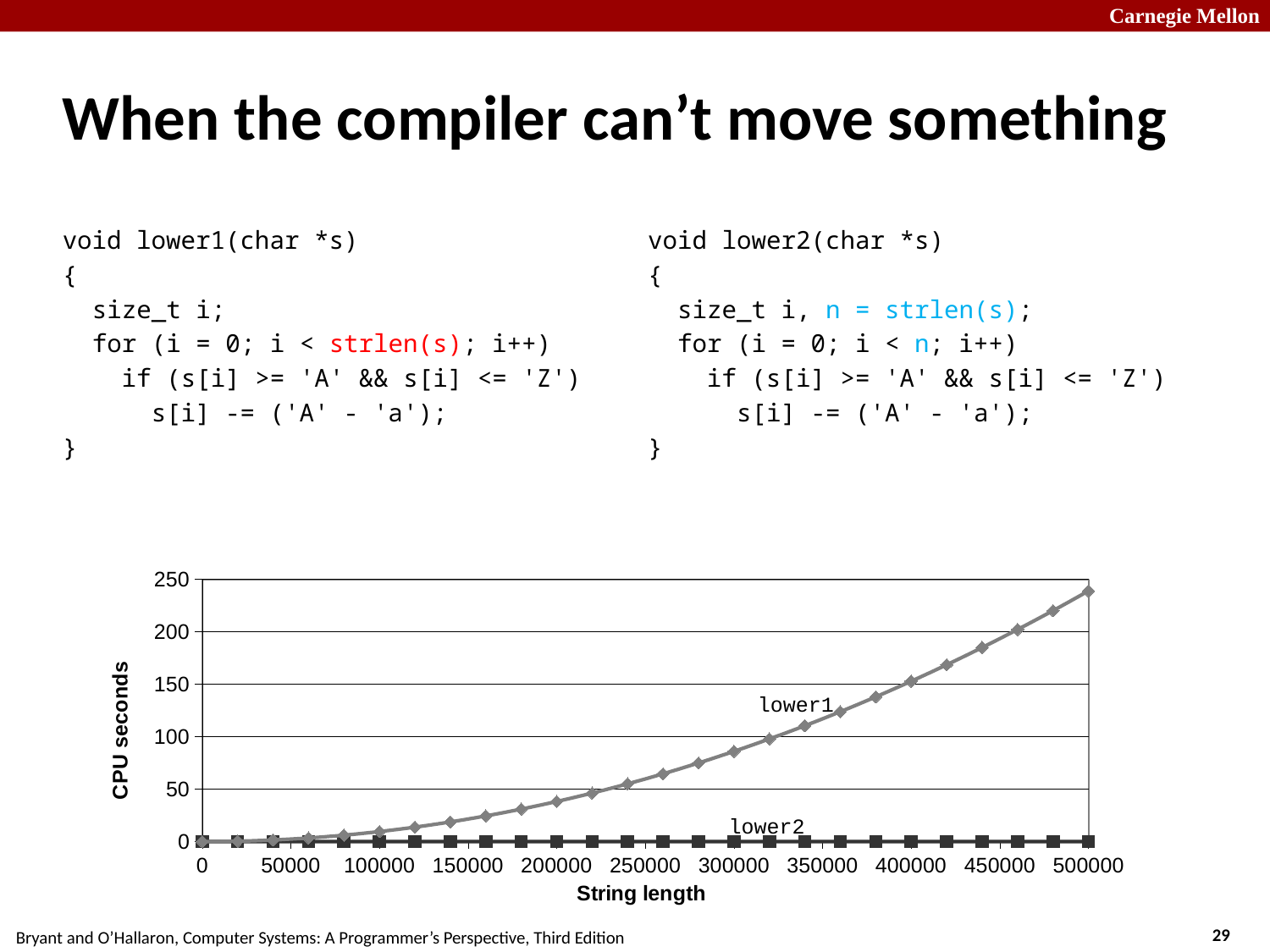
What kind of chart is shown on the slide? line chart Is the CPU seconds value for lower2 at a string length of 500000 greater or less than 50? less Does the CPU time for lower1 rise or fall as string length increases? rise What is the label of the y axis? CPU seconds Is the CPU seconds value for lower1 at a string length of 100000 greater or less than 50? less Which series has the higher CPU seconds at a string length of 500000, lower1 or lower2? lower1 Which series has the lower CPU seconds across the plotted string lengths? lower2 What are the names of the two series plotted on the chart? lower1 and lower2 How many series are plotted on the chart? 2 Is the CPU seconds value for lower1 at a string length of 350000 greater or less than 100? greater